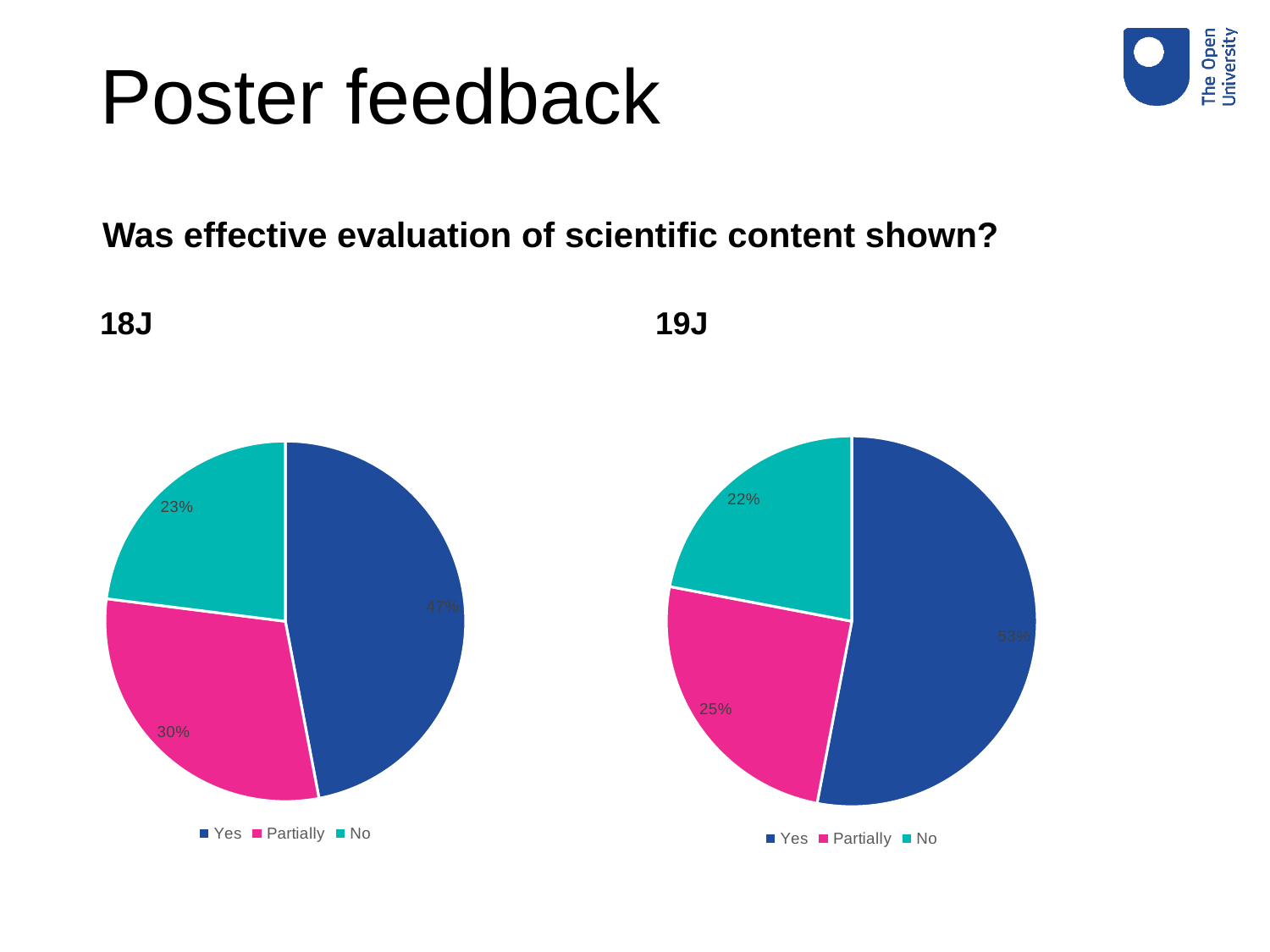
In the 18J pie chart, what percentage of responses were 'No'? 23% In the 19J pie chart, what percentage of responses were 'Yes'? 53% How many categories does the legend of the 19J chart list? 3 In the 18J pie chart, which category has the smallest share? No What is the difference between the 'Yes' share in the 19J chart and the 'Yes' share in the 18J chart? 6% In the 19J pie chart, which category has the largest share? Yes In the 18J pie chart, what percentage of responses were 'Partially'? 30% What type of chart is used for the 18J data? Pie chart In the 19J pie chart, what percentage of responses were 'No'? 22% Which is larger: the 'Partially' share in the 18J chart or the 'Partially' share in the 19J chart? 18J In the 18J pie chart, what percentage of responses were 'Yes'? 47% In the 19J pie chart, what percentage of responses were 'Partially'? 25%